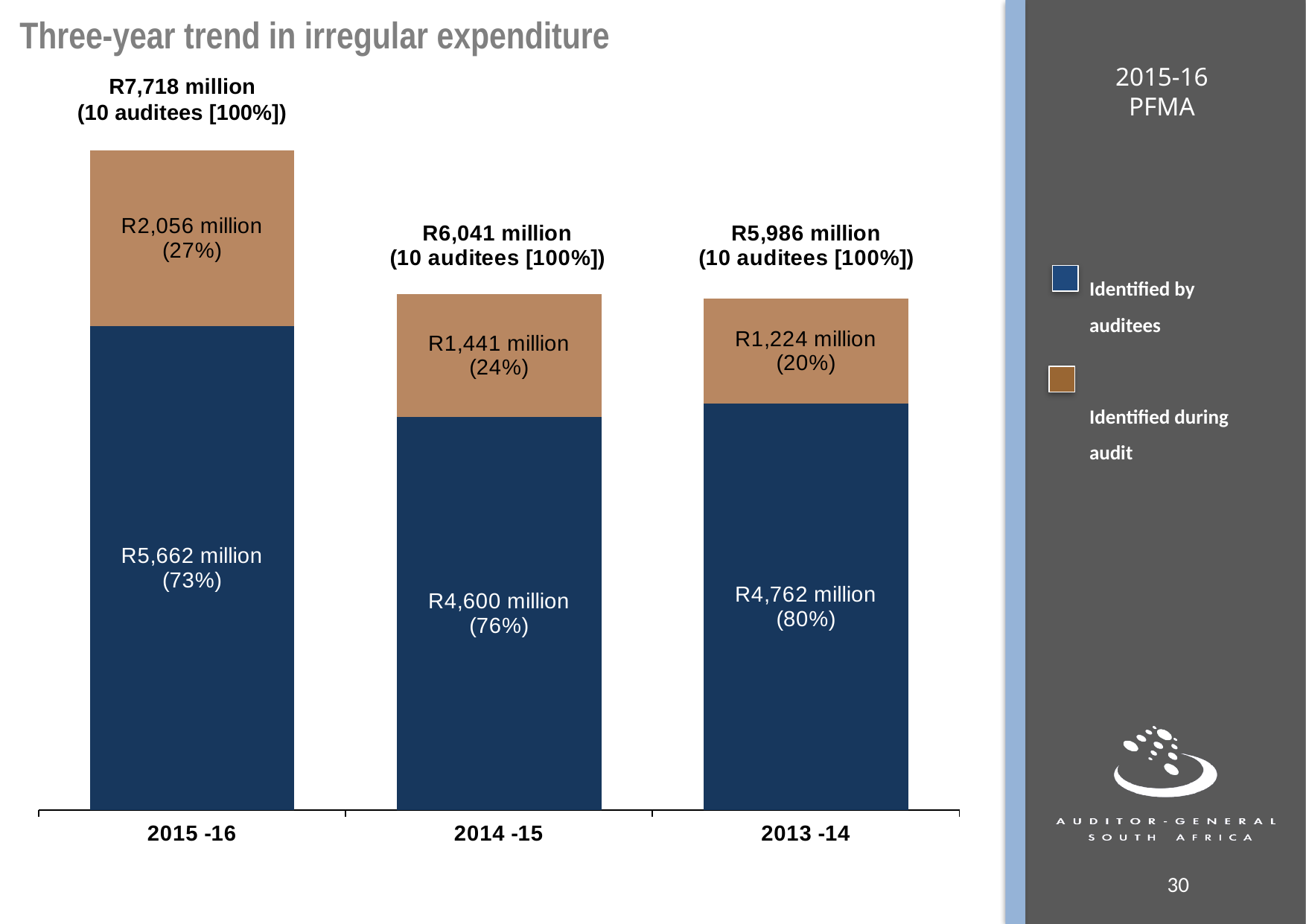
What is the value for 'Identified by auditees' in 2015-16? R5,662 million Which is larger: 'Identified by auditees' in 2013-14 or in 2014-15? 2013 -14 What is the value for 'Identified during audit' in 2013-14? R1,224 million How many years are shown on the x axis? 3 What is the total irregular expenditure for 2014-15? R6,041 million Which year has the highest total irregular expenditure? 2015 -16 What kind of chart is shown on the slide? Stacked bar chart What is the difference between the total irregular expenditure in 2015-16 and 2014-15? R1,677 million What is the title of the chart? Three-year trend in irregular expenditure How many series does the legend list? 2 Which year has the lowest value for 'Identified during audit'? 2013 -14 What percentage of irregular expenditure in 2014-15 was identified during audit? 24%